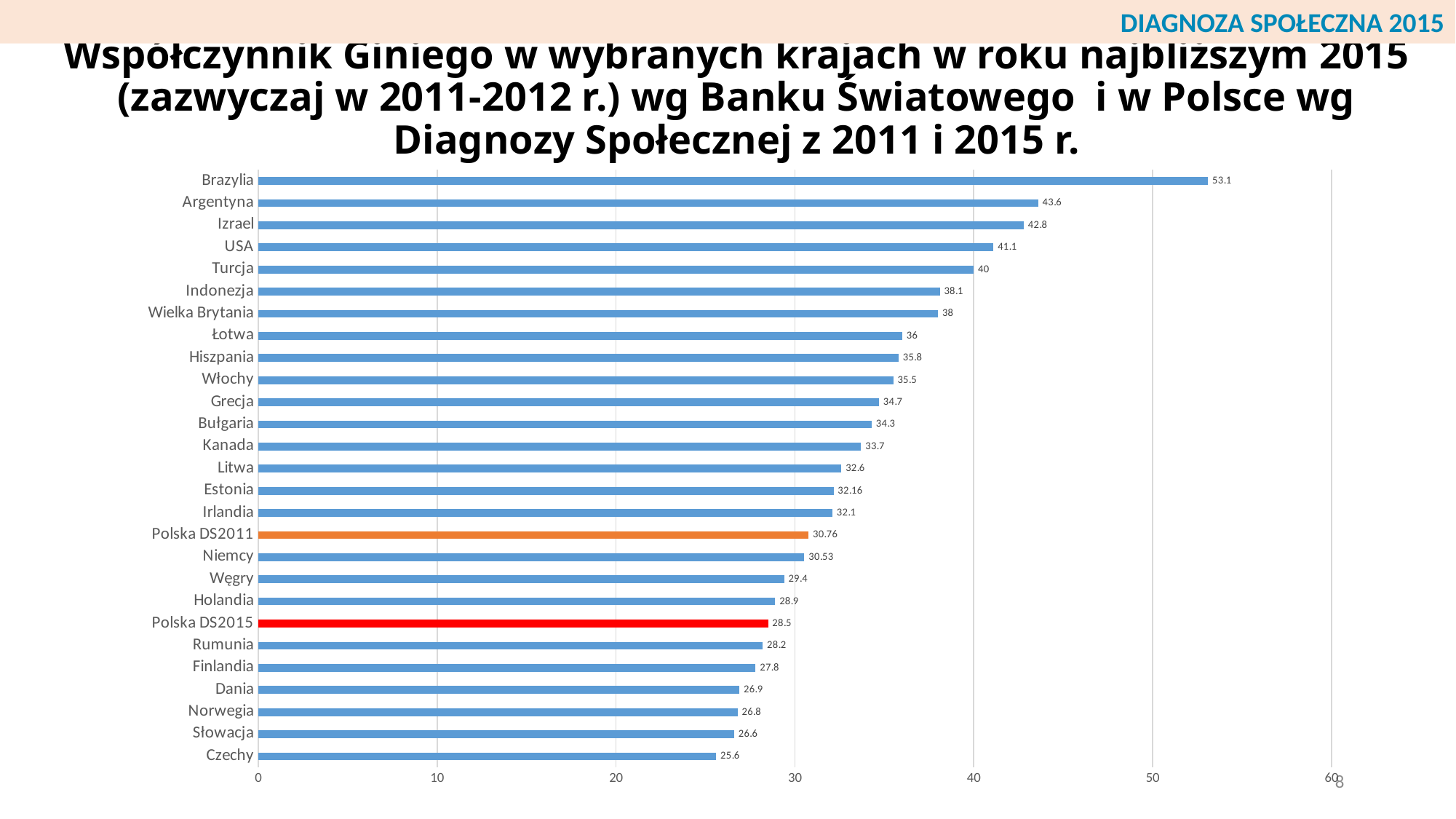
What value is shown for Polska DS2011? 30.76 What is the Gini coefficient value shown for Brazylia? 53.1 What value is shown for Polska DS2015? 28.5 Which has a larger value, USA or Turcja? USA What value is shown for Niemcy? 30.53 What is the difference between the values for Polska DS2011 and Polska DS2015? 2.26 Which country has the lowest value on the chart? Czechy What is the difference between the values for Brazylia and Czechy? 27.5 How many bars (categories) are shown on the chart? 27 What type of chart is shown on the slide? Bar chart What colour is the bar for Polska DS2015? Red Which country has the highest value on the chart? Brazylia